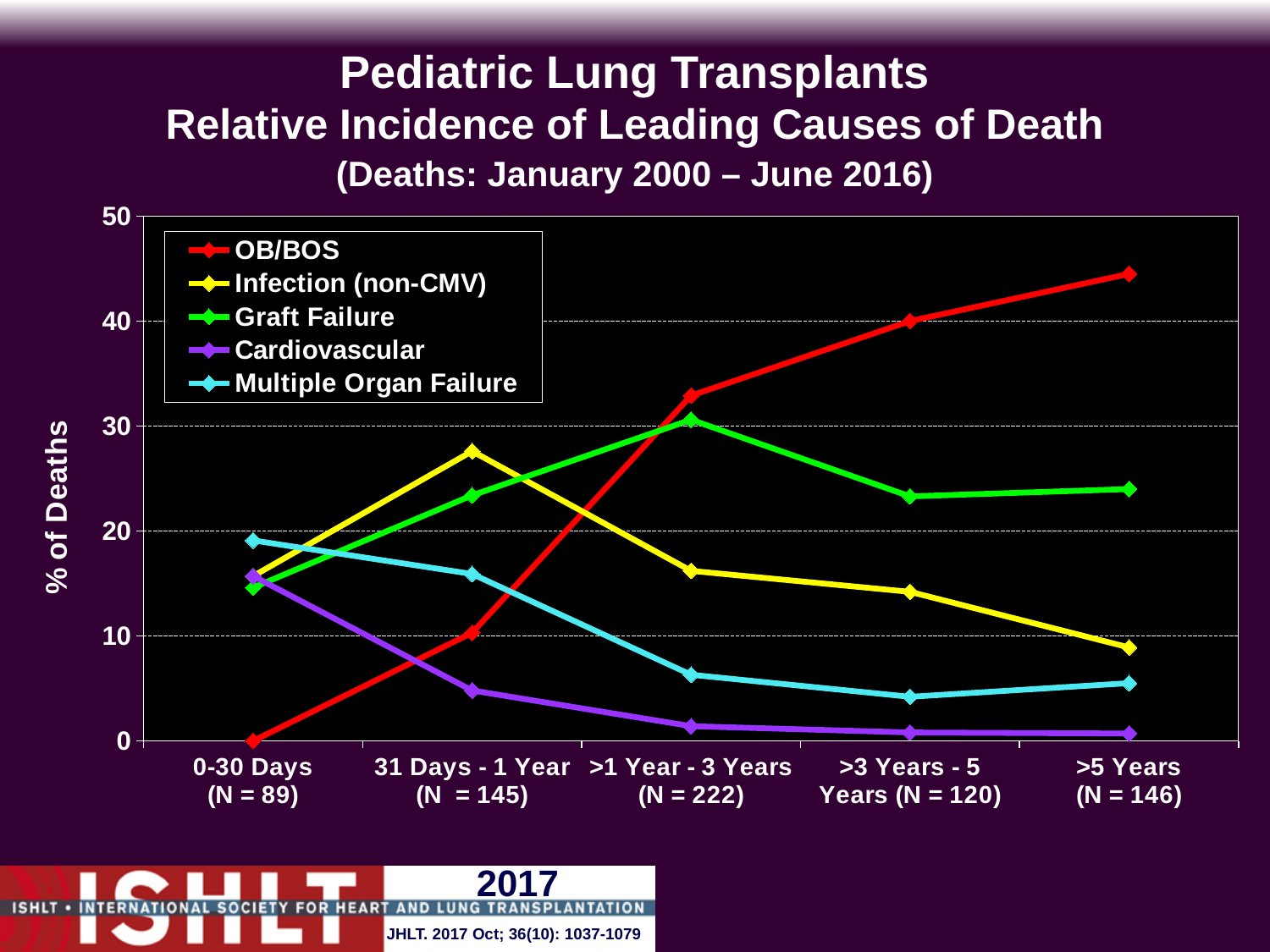
Which cause of death has the highest % of deaths in the 31 Days - 1 Year period? Infection (non-CMV) What kind of chart is shown on the slide? line chart Which cause of death has the highest % of deaths in the >5 Years period? OB/BOS Is the value for Infection (non-CMV) in the 31 Days - 1 Year period greater or less than 20? greater How many time-period categories are shown on the x axis? 5 What is the label of the y axis? % of Deaths In the 0-30 Days period, which is larger: Multiple Organ Failure or OB/BOS? Multiple Organ Failure Is the value for OB/BOS in the >5 Years period greater or less than 40? greater Does the Cardiovascular line rise or fall across the time periods from 0-30 Days to >5 Years? fall Does the OB/BOS line rise or fall across the time periods from 0-30 Days to >5 Years? rise Which cause of death has the lowest % of deaths in the >5 Years period? Cardiovascular How many series does the legend list? 5